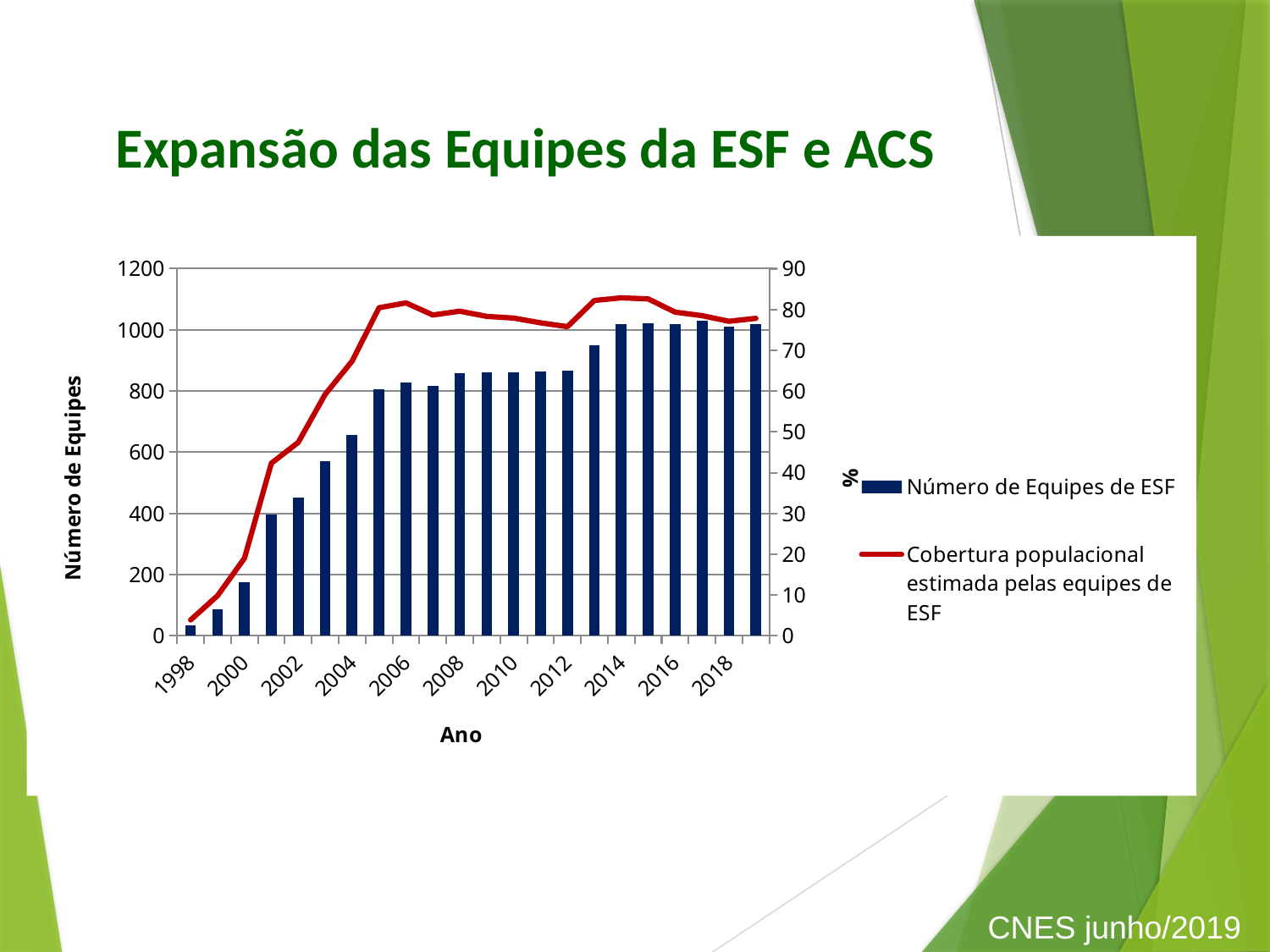
What kind of chart is shown on the slide? A combined bar and line chart Which year has the larger Número de Equipes de ESF, 2002 or 2012? 2012 Is the value for Número de Equipes de ESF in 2000 greater or less than 200? less Is the Cobertura populacional estimada pelas equipes de ESF in 1998 greater or less than 10? less Is the value for Número de Equipes de ESF in 2004 greater or less than 600? greater How many bars (years) are plotted in the chart? 22 What is the title of the x axis of the chart? Ano Which year has the lowest value for Número de Equipes de ESF? 1998 How many series does the legend list? 2 Does the Número de Equipes de ESF generally rise or fall from 1998 to 2019? rise